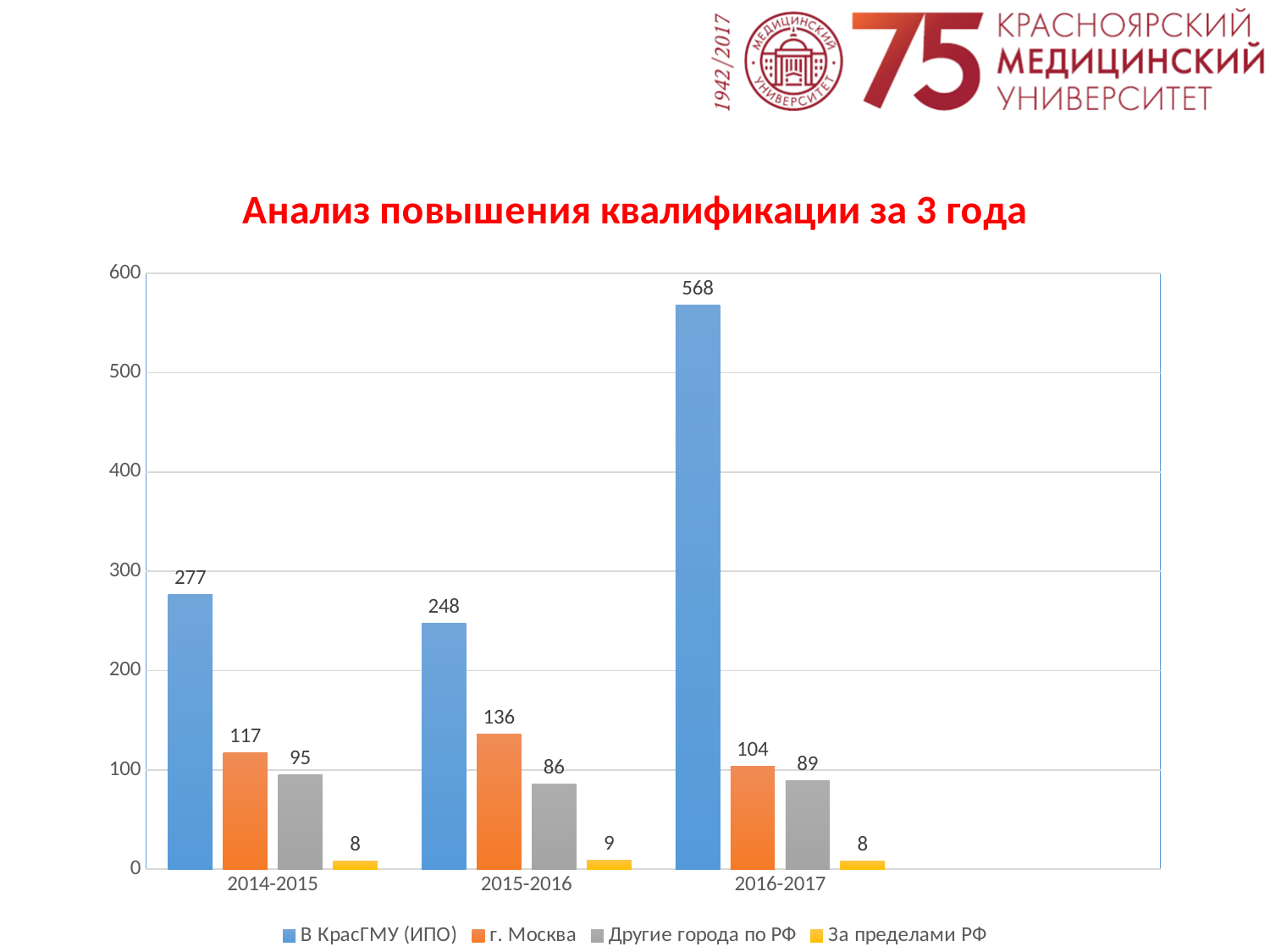
What is the difference between the В КрасГМУ (ИПО) values for 2016-2017 and 2015-2016? 320 What is the value for За пределами РФ in 2015-2016? 9 What is the value for В КрасГМУ (ИПО) in 2016-2017? 568 What is the value for Другие города по РФ in 2014-2015? 95 What is the value for г. Москва in 2015-2016? 136 In which period is the value for В КрасГМУ (ИПО) highest? 2016-2017 How many periods are shown on the x axis? 3 How many series does the legend list? 4 What is the title of the chart? Анализ повышения квалификации за 3 года Which is larger: Другие города по РФ in 2015-2016 or in 2016-2017? 2016-2017 What kind of chart is shown on the slide? Bar chart In which period is the value for г. Москва lowest? 2016-2017